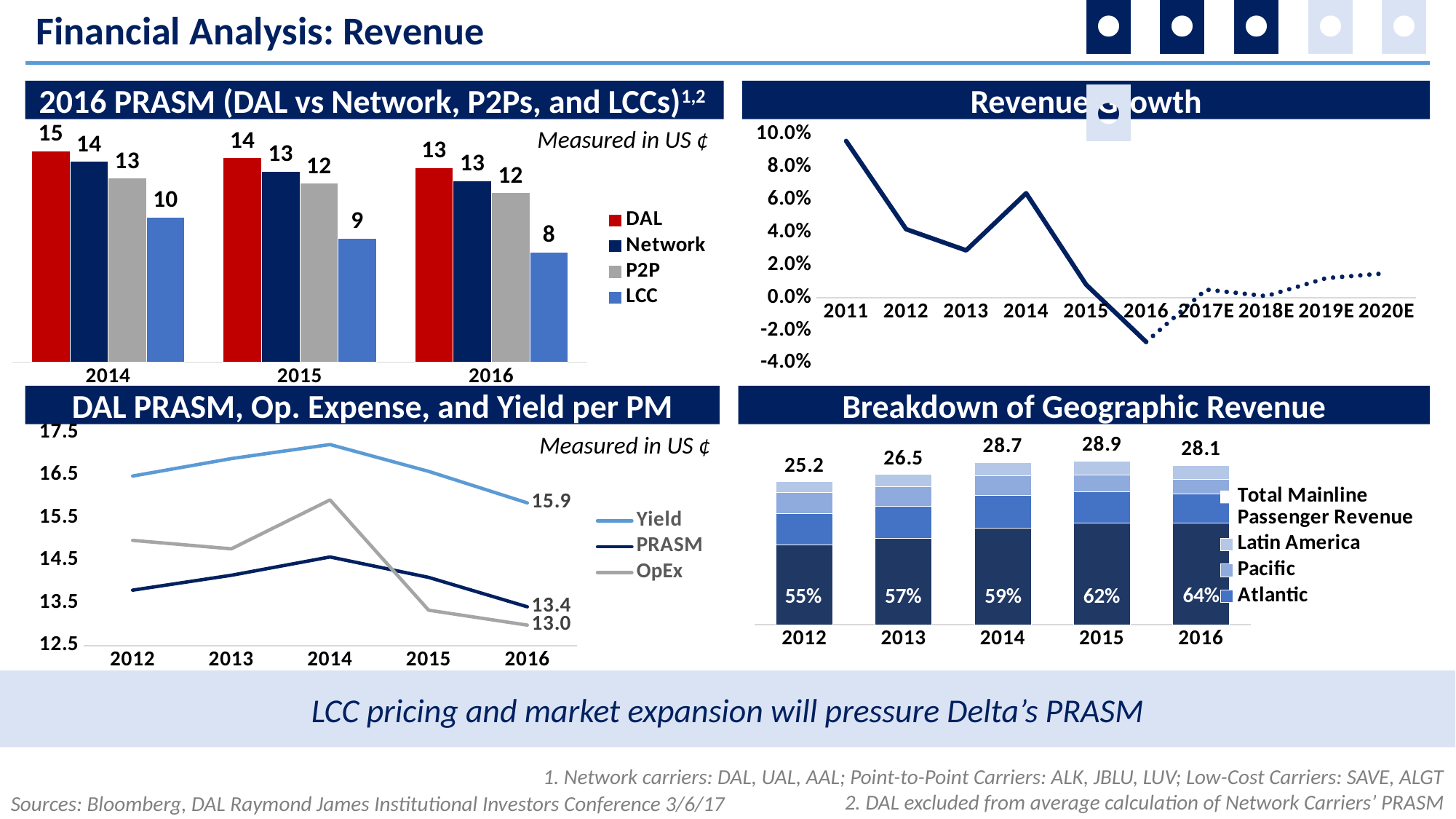
In the '2016 PRASM (DAL vs Network, P2Ps, and LCCs)' chart, what is the DAL value for 2014? 15 In the '2016 PRASM (DAL vs Network, P2Ps, and LCCs)' chart, which series has the lowest value in 2015? LCC What kind of chart is the 'Revenue Growth' chart? Line chart In the 'Breakdown of Geographic Revenue' chart, which year has the highest total? 2015 How many series does the legend of the '2016 PRASM (DAL vs Network, P2Ps, and LCCs)' chart list? 4 In the 'Revenue Growth' chart, is the value for 2011 greater or less than 8.0%? greater In the '2016 PRASM (DAL vs Network, P2Ps, and LCCs)' chart, what is the difference between the DAL and LCC values in 2014? 5 In the 'DAL PRASM, Op. Expense, and Yield per PM' chart, what is the difference between the PRASM and OpEx values in 2016? 0.4 In the 'DAL PRASM, Op. Expense, and Yield per PM' chart, what is the Yield value for 2016? 15.9 In the '2016 PRASM (DAL vs Network, P2Ps, and LCCs)' chart, what is the LCC value for 2016? 8 In the 'Revenue Growth' chart, is the value for 2016 greater or less than 0.0%? less In the 'Breakdown of Geographic Revenue' chart, what percentage is shown on the bottom segment of the 2016 bar? 64%